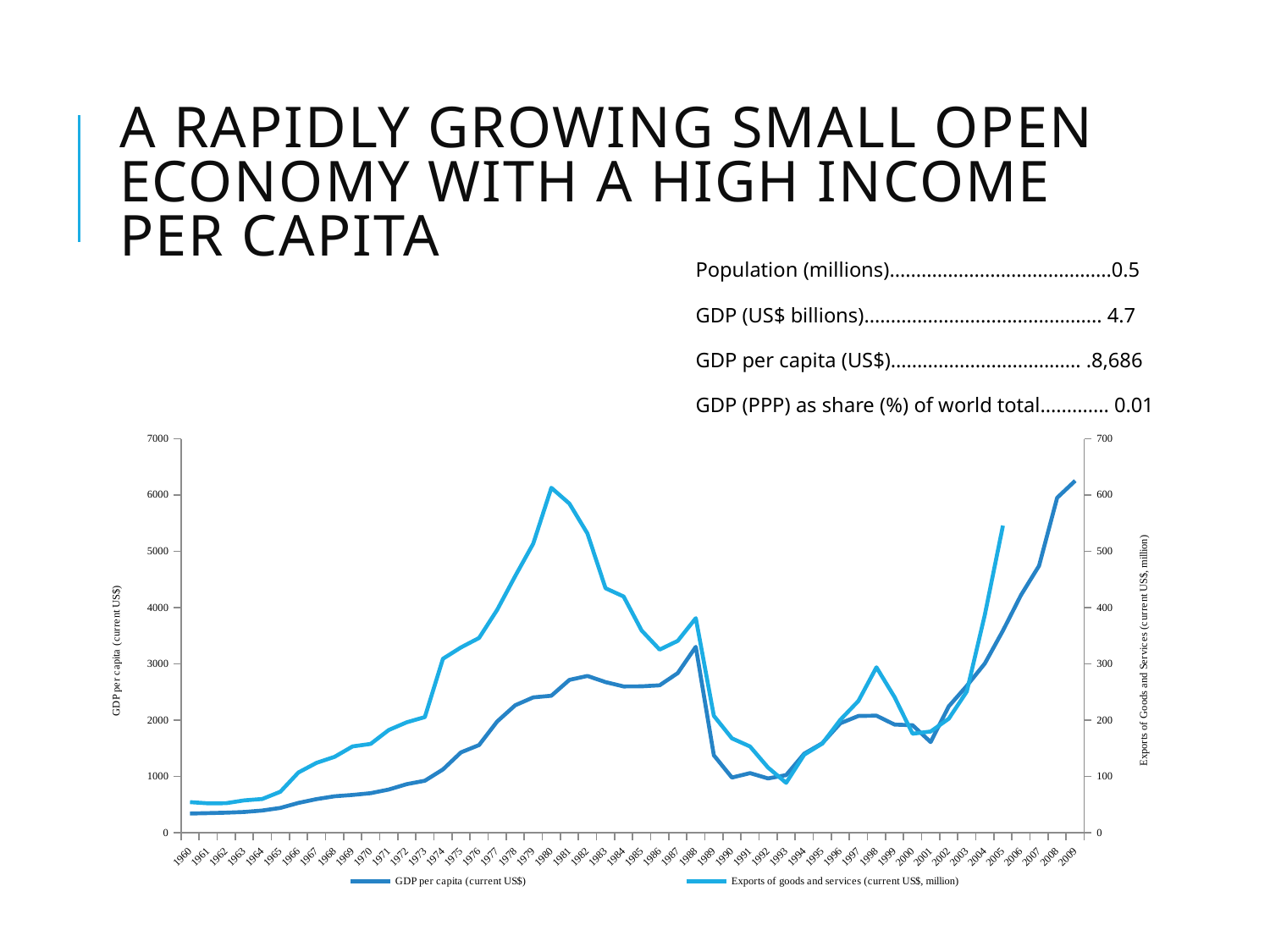
What is the title of the left vertical axis of the chart? GDP per capita (current US$) Is the Exports of goods and services value for 1980 greater or less than 500? greater What kind of chart is shown on the slide? Line chart How many years are plotted along the x axis of the chart? 50 In which year does the Exports of goods and services series reach its highest value? 1980 What is the title of the right vertical axis of the chart? Exports of Goods and Services (current US$, million) Is the GDP per capita (current US$) value for 2001 greater or less than 2000? less Is the GDP per capita (current US$) value for 1960 greater or less than 1000? less In which year does the GDP per capita (current US$) series reach its highest value? 2009 Does the GDP per capita (current US$) series rise or fall between 1960 and 1988? rise How many series does the chart legend list? 2